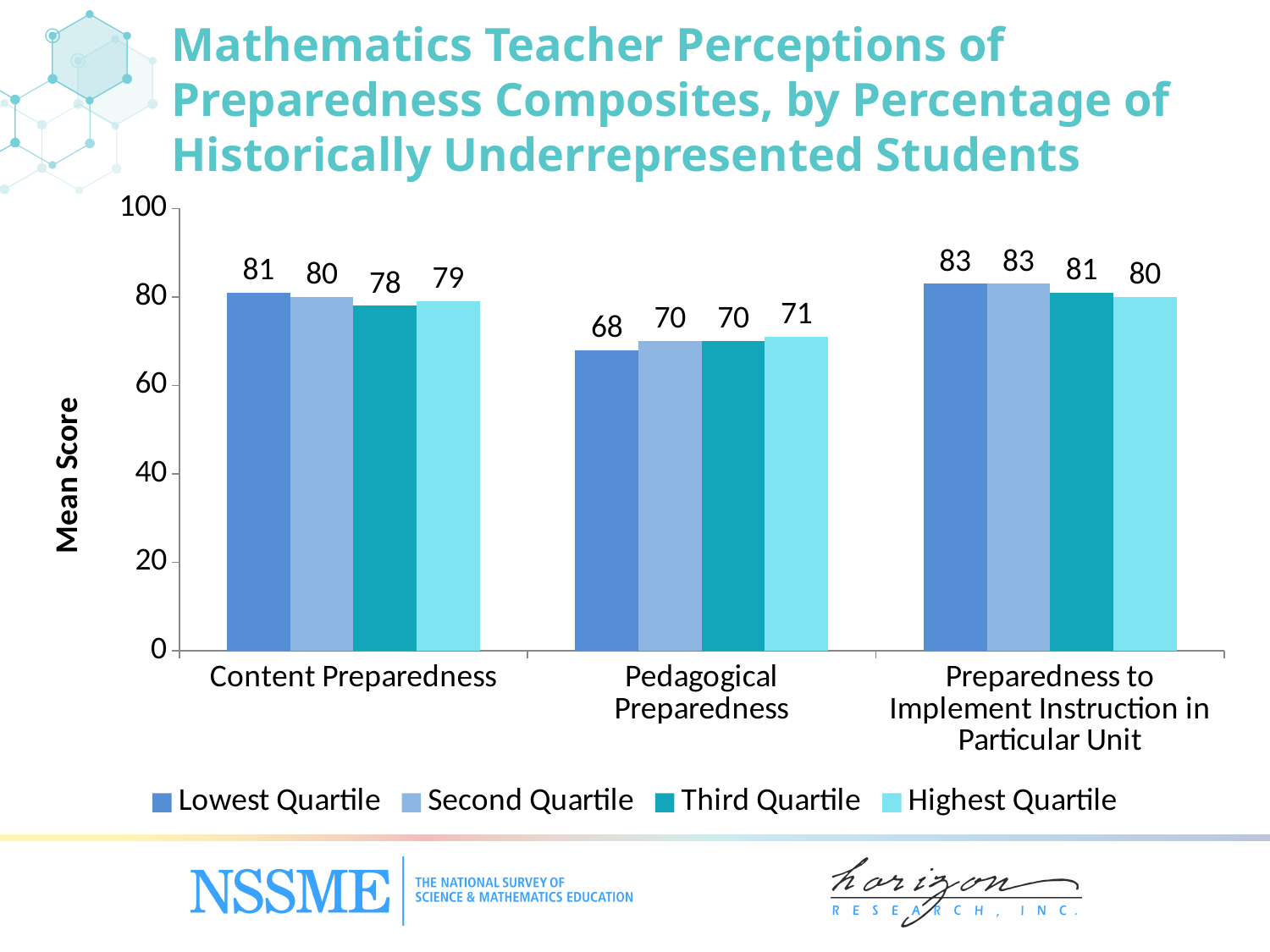
What is the label of the y axis? Mean Score What is the mean score for the Third Quartile on Preparedness to Implement Instruction in Particular Unit? 81 What is the mean score for the Lowest Quartile on Content Preparedness? 81 Which quartile has the lowest mean score on Pedagogical Preparedness? Lowest Quartile How many series does the legend list? 4 How many categories are shown on the x axis? 3 What is the difference between the Lowest Quartile mean scores on Content Preparedness and Pedagogical Preparedness? 13 Which quartile has the lowest mean score on Content Preparedness? Third Quartile What kind of chart is shown on the slide? Bar chart Is the Second Quartile mean score higher on Content Preparedness or on Pedagogical Preparedness? Content Preparedness What is the difference between the Lowest Quartile and Highest Quartile mean scores on Preparedness to Implement Instruction in Particular Unit? 3 What is the mean score for the Highest Quartile on Pedagogical Preparedness? 71